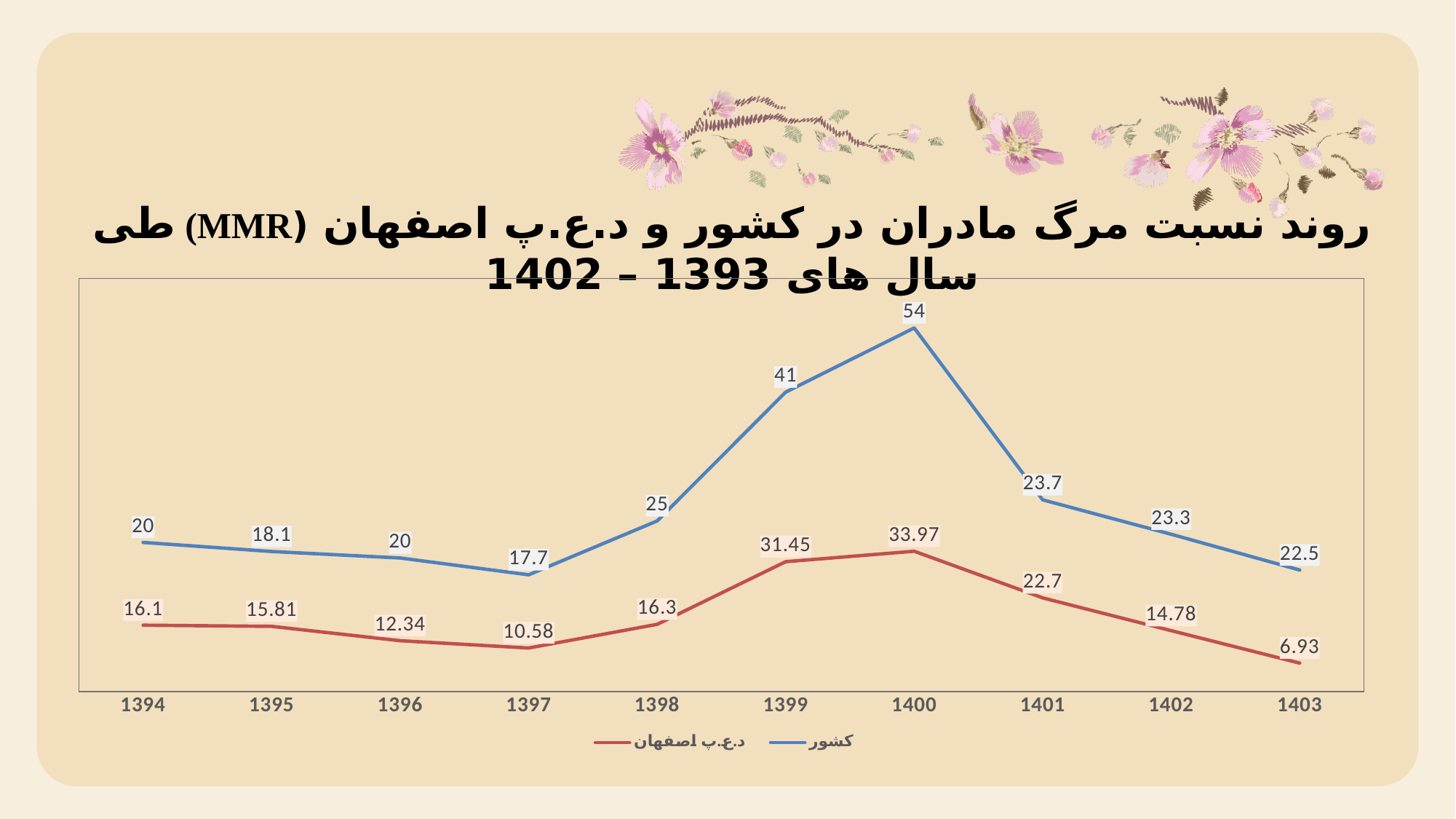
What is the difference between the کشور value and the د.ع.پ اصفهان value in 1400? 20.03 What is the value for کشور in 1399? 41 Does the کشور series rise or fall from 1400 to 1403? Fall In which year does the د.ع.پ اصفهان series reach its lowest value? 1403 What is the value for کشور in 1400? 54 How many series does the legend list? 2 How many years are shown on the x axis? 10 What is the value for د.ع.پ اصفهان in 1397? 10.58 What kind of chart is shown on the slide? Line chart Which series has the larger value in 1401, کشور or د.ع.پ اصفهان? کشور What is the value for د.ع.پ اصفهان in 1403? 6.93 In which year does the کشور series reach its highest value? 1400